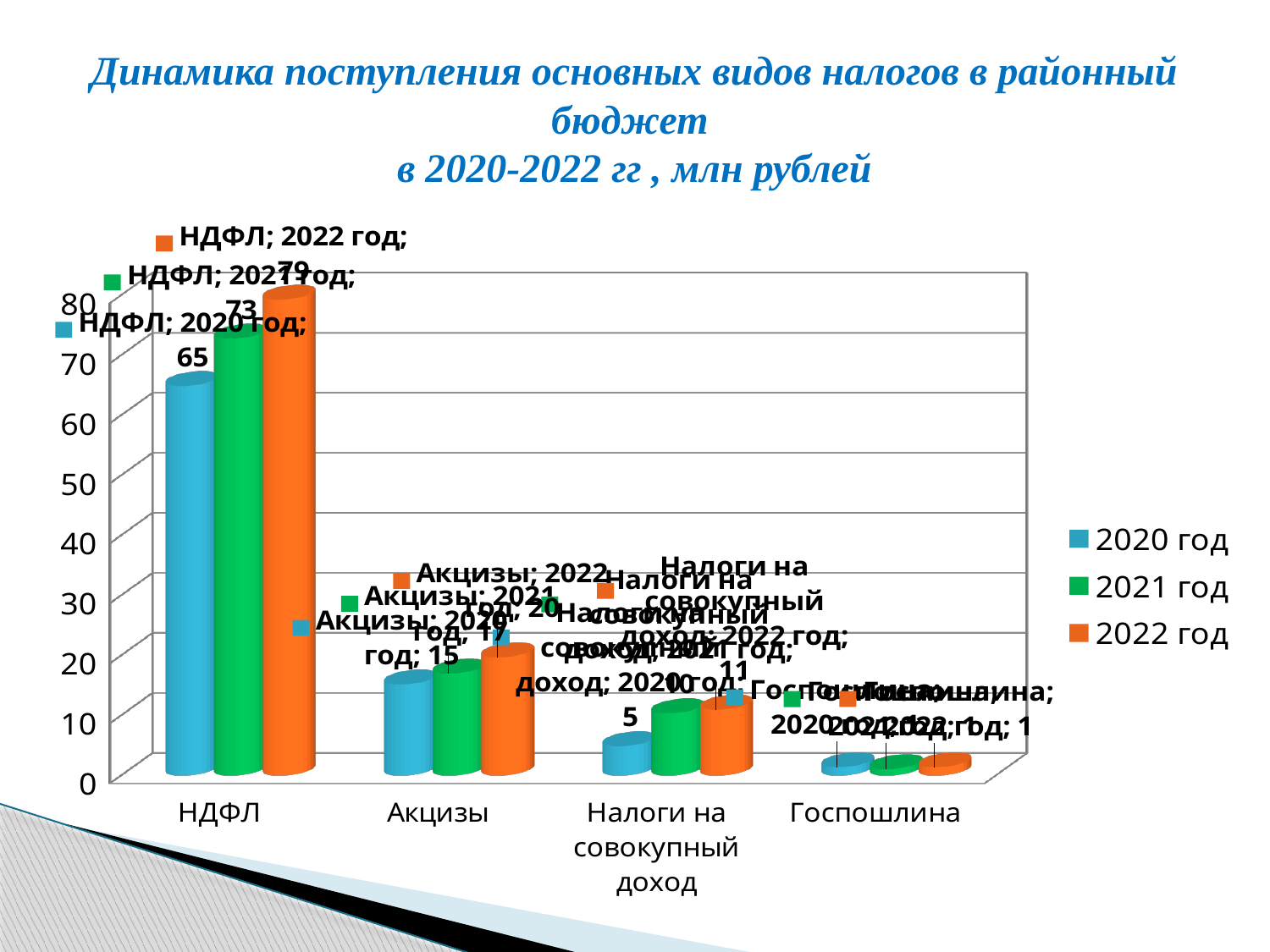
What kind of chart is shown on the slide? bar chart What is the value for Акцизы in 2020 год? 15 Which tax category has the lowest values on the chart? Госпошлина How many tax categories are shown on the x axis? 4 What is the value for НДФЛ in 2021 год? 73 What is the value for НДФЛ in 2022 год? 79 How many series does the legend list? 3 Which tax category has the highest values on the chart? НДФЛ What is the value for НДФЛ in 2020 год? 65 By how much did НДФЛ increase from 2020 год to 2022 год? 14 Do the values for НДФЛ rise or fall from 2020 год to 2022 год? rise Is the value for Госпошлина in 2020 год greater or less than 10? less